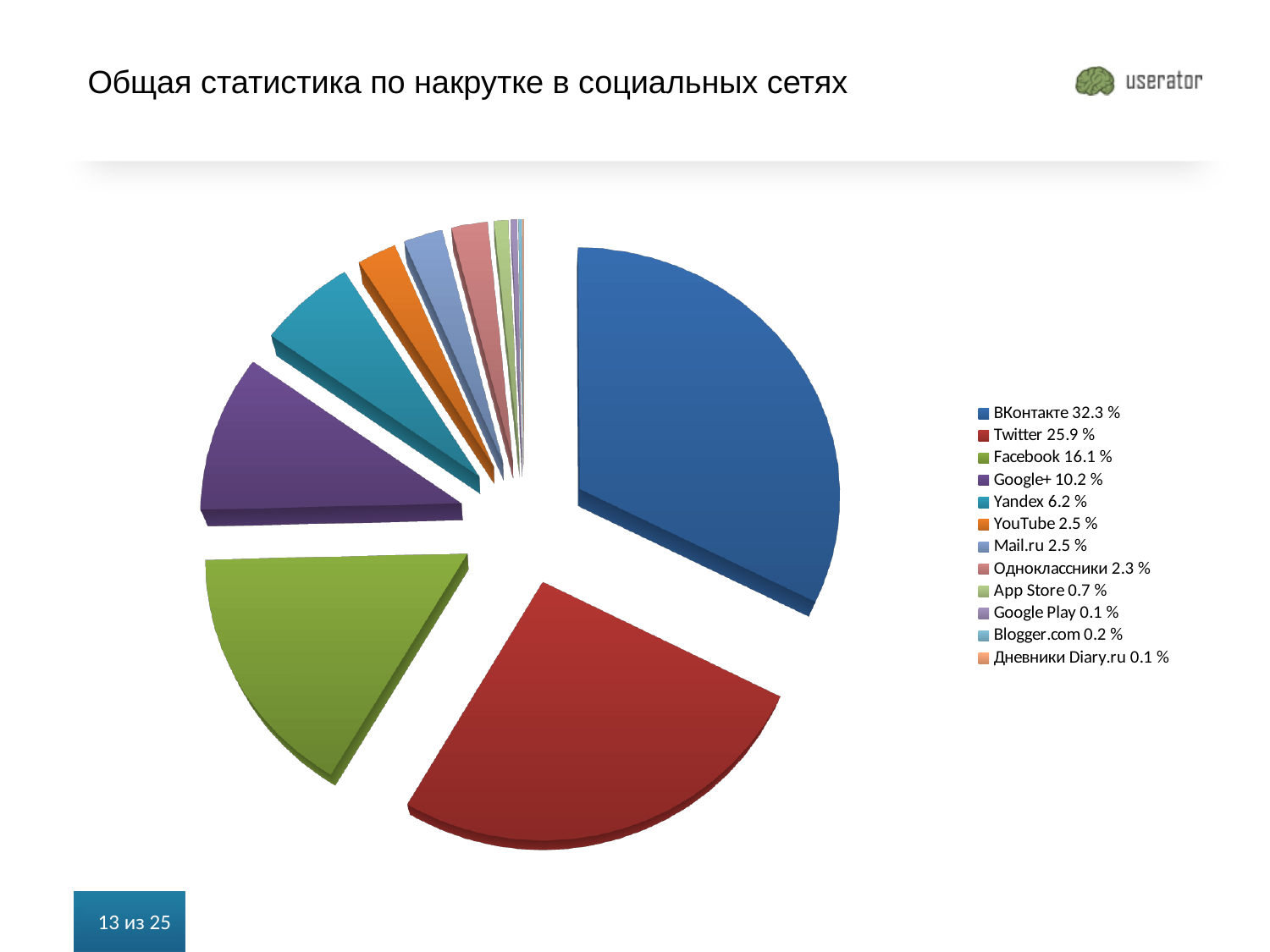
What kind of chart is shown on the slide? pie chart What is the value shown for Twitter in the legend? 25.9 % Which has a larger share, Facebook or Google+? Facebook What is the value shown for Google+? 10.2 % Which category has the largest share of the pie? ВКонтакте How many categories are listed in the legend? 12 What is the value shown for Yandex? 6.2 % What is the difference between the shares of ВКонтакте and Twitter? 6.4 % What is the value shown for Одноклассники? 2.3 % What share of the pie does ВКонтакте have? 32.3 % What is the title of the slide containing the chart? Общая статистика по накрутке в социальных сетях What is the value shown for Facebook? 16.1 %